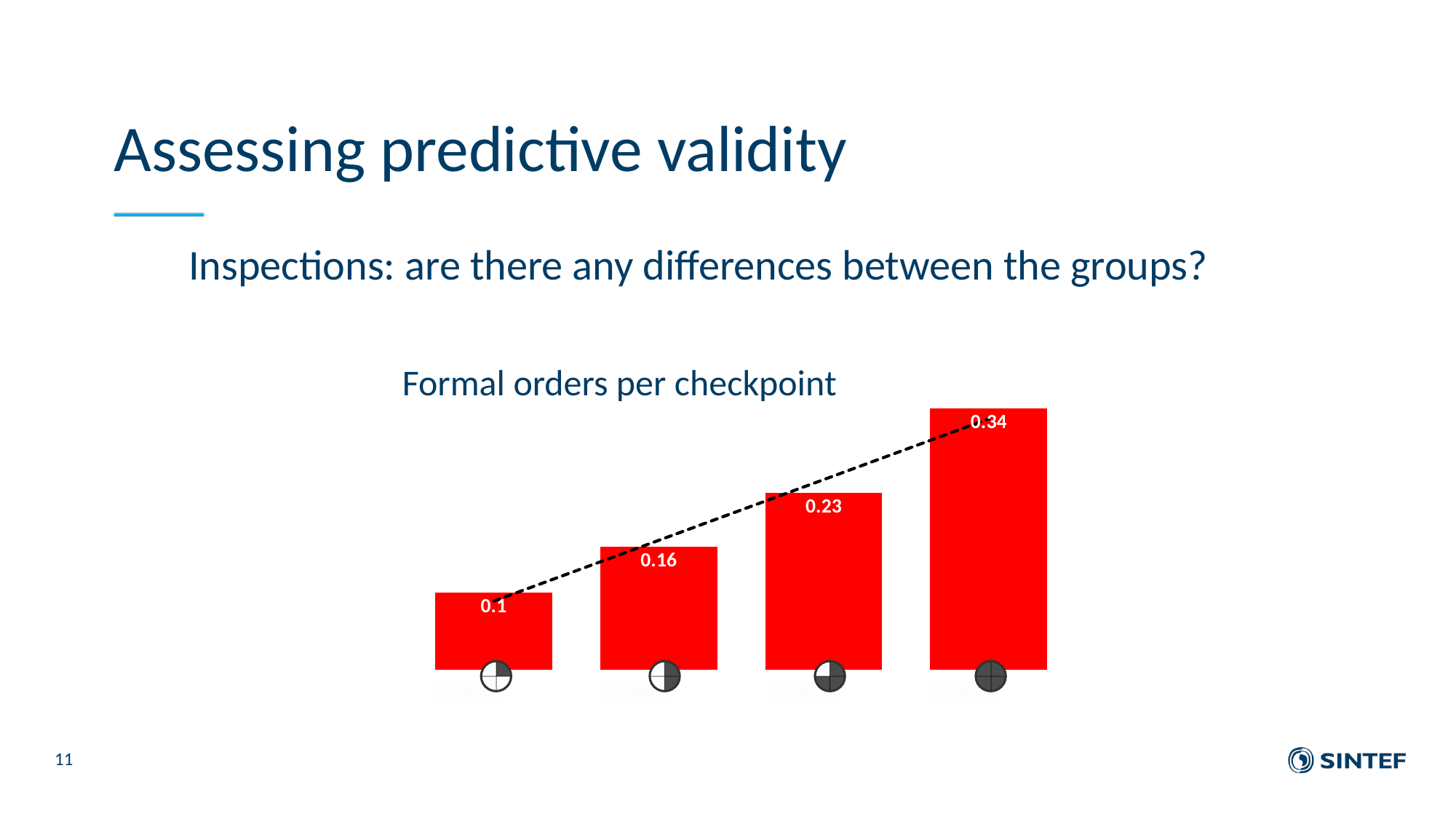
Which is larger, the second bar from the left or the third bar from the left? The third bar (0.23) What is the value of the leftmost bar in the chart? 0.1 What is the value of the rightmost bar in the chart? 0.34 Which bar has the highest value in the chart? The rightmost bar (0.34) Which bar has the lowest value in the chart? The leftmost bar (0.1) What is the value of the third bar from the left in the chart? 0.23 What is the value of the second bar from the left in the chart? 0.16 What is the difference between the third bar and the second bar from the left? 0.07 How many bars are shown in the chart? 4 What kind of chart is shown on the slide? Bar chart What is the difference between the rightmost bar and the leftmost bar? 0.24 Do the bar values rise or fall from left to right? Rise